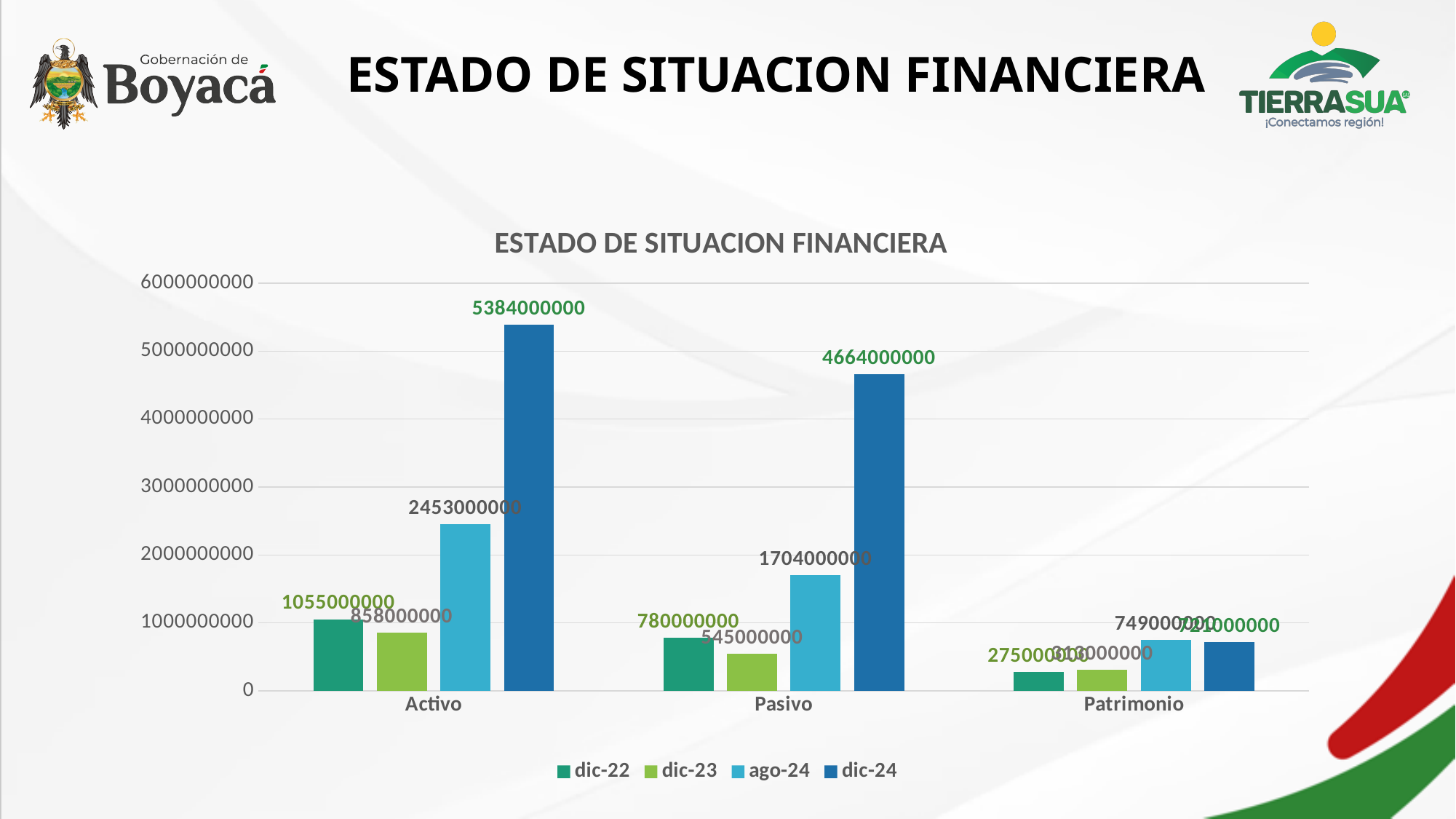
Which is larger, the dic-22 value for Activo or the dic-22 value for Pasivo? Activo What is the value for dic-24 in the Pasivo category? 4664000000 How many series does the legend list? 4 What is the difference between the ago-24 and dic-23 values in the Pasivo category? 1159000000 What is the value for dic-23 in the Activo category? 858000000 What is the value for dic-23 in the Pasivo category? 545000000 Which category has the highest dic-24 value? Activo What kind of chart is shown on the slide? Bar chart What is the value for ago-24 in the Pasivo category? 1704000000 What is the value for ago-24 in the Activo category? 2453000000 What is the value for dic-22 in the Activo category? 1055000000 Is the value for dic-24 in the Activo category greater or less than 5000000000? greater